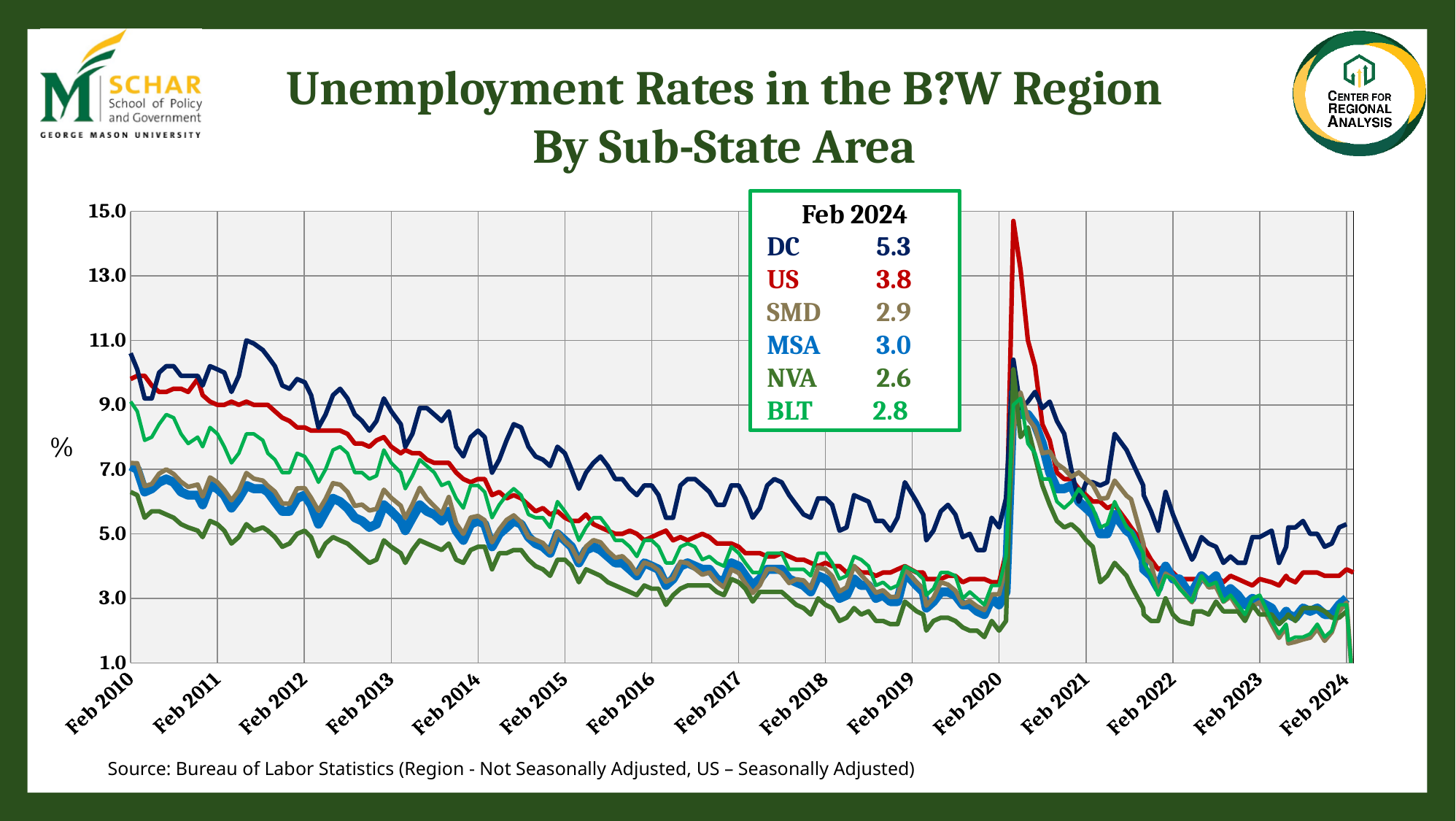
What is the difference between the DC and US unemployment rates in Feb 2024? 1.5 What is the unemployment rate for DC in Feb 2024? 5.3 What label is shown on the vertical axis of the chart? % What is the unemployment rate for NVA in Feb 2024? 2.6 Is the US unemployment rate at its 2020 peak greater or less than 13.0? greater Which area has the highest unemployment rate in Feb 2024? DC How many series does the legend box list? 6 What is the unemployment rate for the US in Feb 2024? 3.8 In Feb 2024, which has the higher unemployment rate, MSA or SMD? MSA Does the DC unemployment rate generally rise or fall from Feb 2010 to Feb 2020? Fall What type of chart is shown on the slide? Line chart Which area has the lowest unemployment rate in Feb 2024? NVA